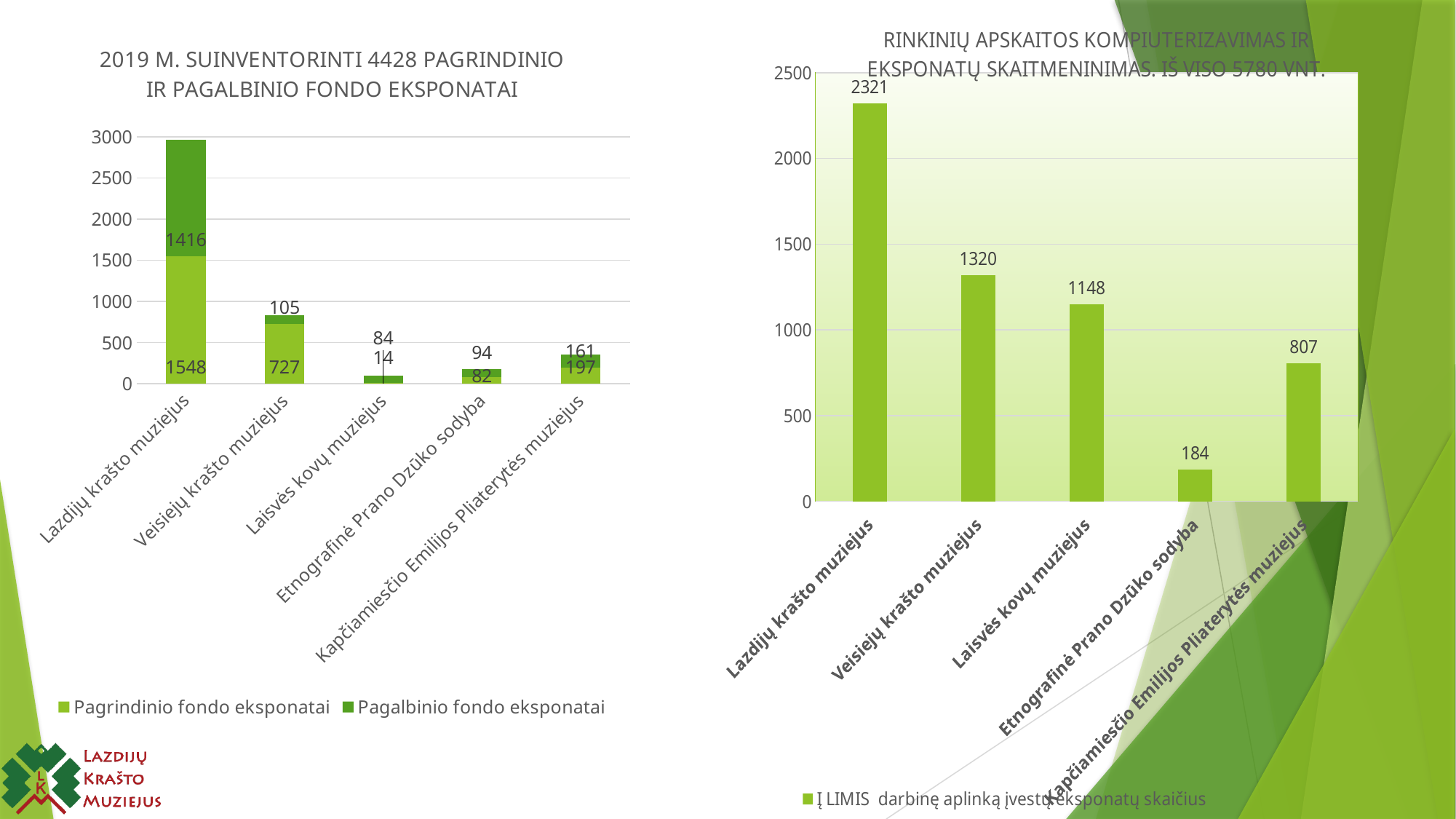
In the right chart, how many categories are shown on the x axis? 5 In the right chart, which category has the highest value? Lazdijų krašto muziejus What type of chart is the right chart? Bar chart In the left chart, which category has the lowest value of Pagrindinio fondo eksponatai? Laisvės kovų muziejus In the left chart, what is the difference between Pagrindinio fondo eksponatai and Pagalbinio fondo eksponatai for Veisiejų krašto muziejus? 622 In the left chart, what is the total of the stacked bar for Kapčiamiesčio Emilijos Pliaterytės muziejus? 358 In the left chart, what is the value of Pagalbinio fondo eksponatai for Veisiejų krašto muziejus? 105 In the left chart (2019 m. suinventorinti eksponatai), what is the value of Pagrindinio fondo eksponatai for Lazdijų krašto muziejus? 1548 In the left chart, how many series does the legend list? 2 In the left chart, what is the total of the stacked bar for Lazdijų krašto muziejus? 2964 In the right chart, what is the difference between Veisiejų krašto muziejus and Etnografinė Prano Dzūko sodyba? 1136 In the right chart (Rinkinių apskaitos kompiuterizavimas), what is the value for Laisvės kovų muziejus? 1148